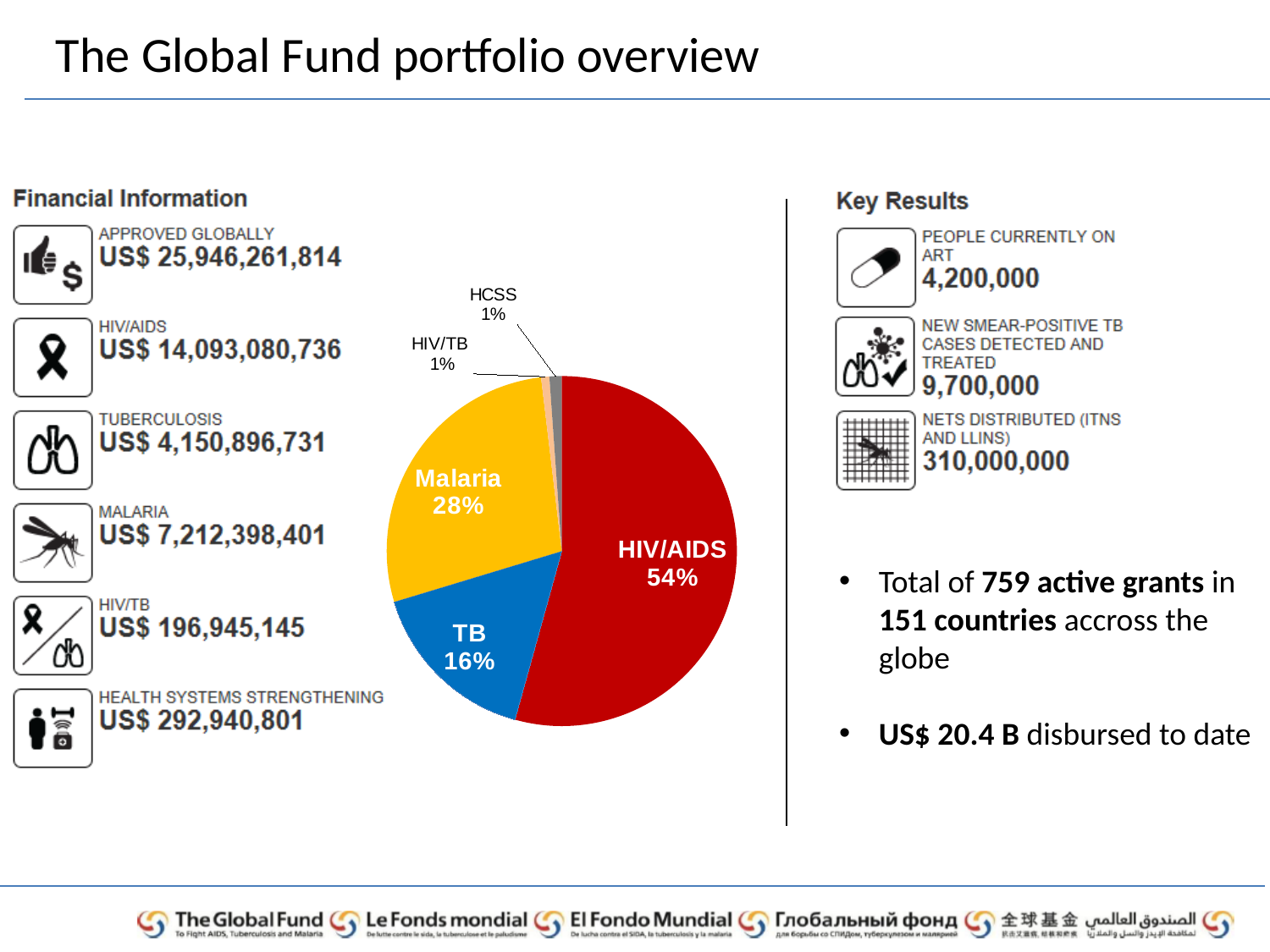
What share of the pie does HIV/TB represent? 1% Which is larger in the pie chart, Malaria or TB? Malaria Which slice of the pie chart is the largest? HIV/AIDS What share of the pie does HIV/AIDS represent? 54% What share of the pie does TB represent? 16% What kind of chart is shown on the slide? pie chart What is the difference in percentage points between the HIV/AIDS slice and the Malaria slice? 26 What colour is the HIV/AIDS slice of the pie chart? red What is the difference in percentage points between the Malaria slice and the TB slice? 12 How many slices does the pie chart have? 5